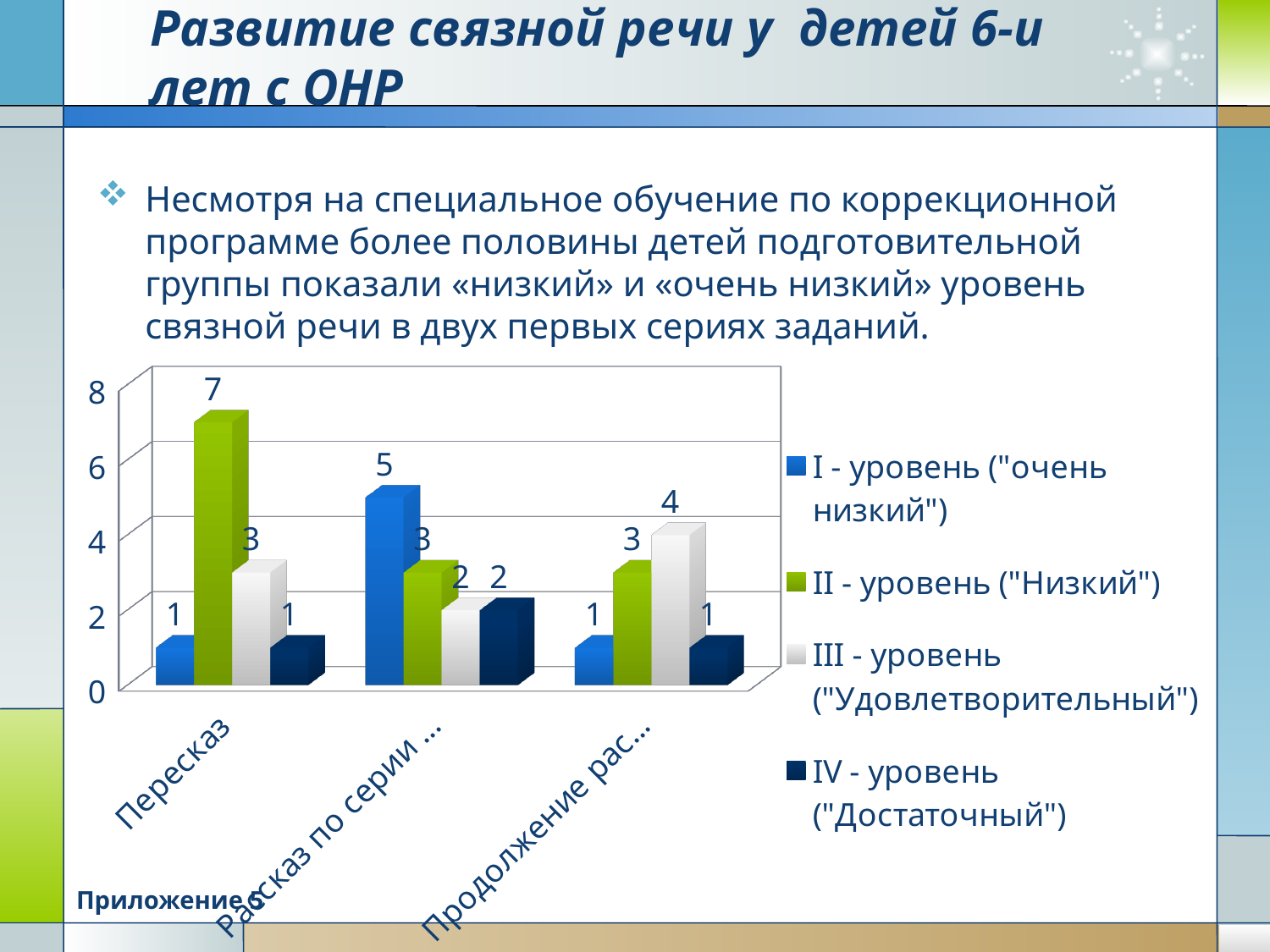
For the third category (Продолжение рас...), which is larger: the value of II - уровень ("Низкий") or III - уровень ("Удовлетворительный")? III - уровень ("Удовлетворительный") What is the difference between the II - уровень ("Низкий") value and the I - уровень ("очень низкий") value for the category Пересказ? 6 Which series has the highest value for the second category (Рассказ по серии ...)? I - уровень ("очень низкий") What is the value of I - уровень ("очень низкий") for the second category (Рассказ по серии ...)? 5 What colour are the bars for IV - уровень ("Достаточный") in the chart? dark navy blue What is the value of III - уровень ("Удовлетворительный") for the category Пересказ? 3 What is the value of II - уровень ("Низкий") for the category Пересказ? 7 Which series has the highest value for the category Пересказ? II - уровень ("Низкий") What is the value of III - уровень ("Удовлетворительный") for the third category (Продолжение рас...)? 4 How many categories are shown on the x axis of the chart? 3 How many series does the chart legend list? 4 What kind of chart is shown on the slide? bar chart